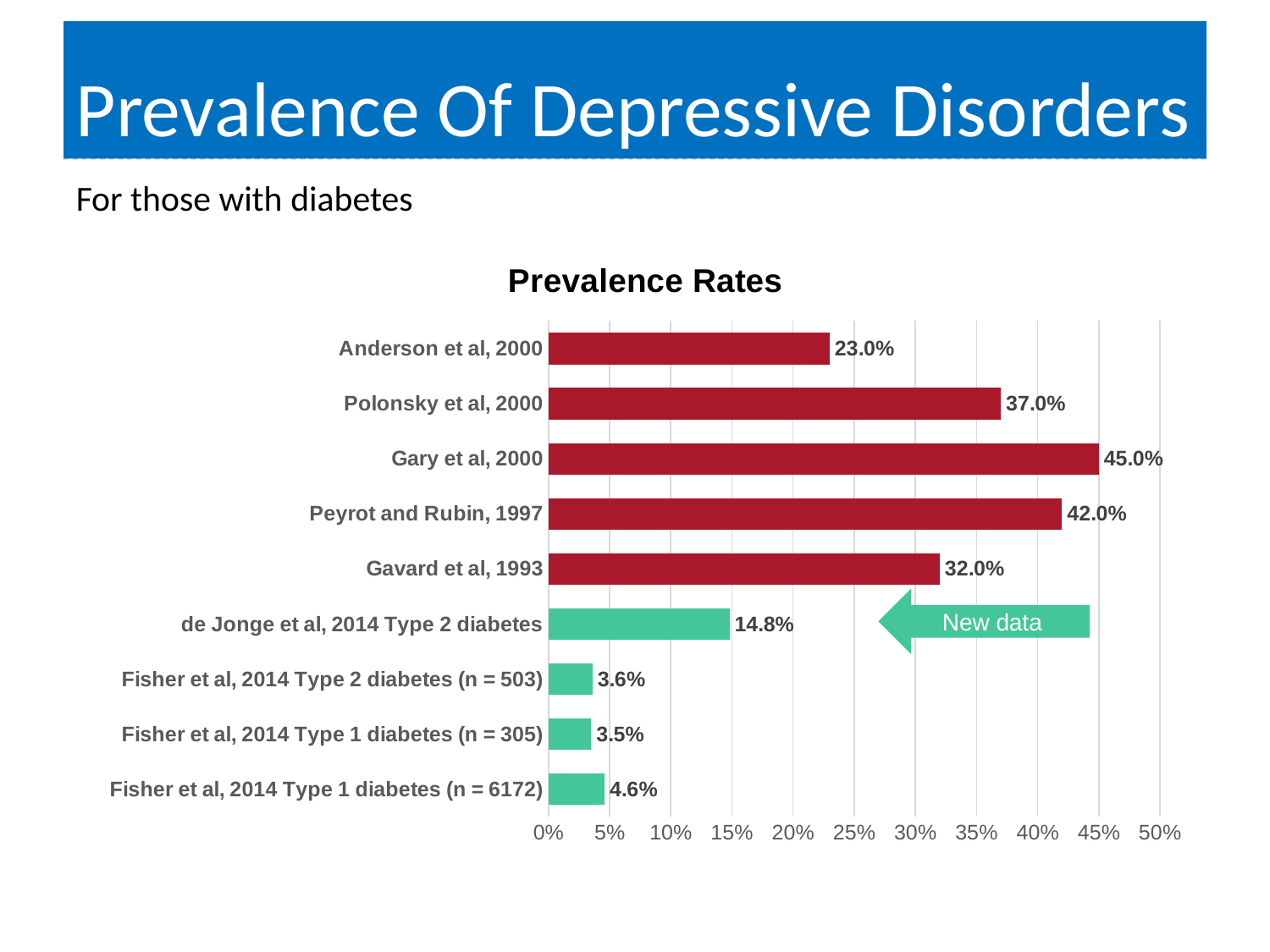
How many studies are shown in the chart? 9 What is the prevalence rate for Fisher et al, 2014 Type 1 diabetes (n = 6172)? 4.6% Which study has the lowest prevalence rate? Fisher et al, 2014 Type 1 diabetes (n = 305) What is the prevalence rate for Anderson et al, 2000? 23.0% What type of chart is shown on the slide? bar chart What does the arrow label pointing at the green bars say? New data Which has a higher prevalence rate, Polonsky et al, 2000 or Peyrot and Rubin, 1997? Peyrot and Rubin, 1997 What is the difference between the prevalence rates of Gary et al, 2000 and Gavard et al, 1993? 13.0% What is the prevalence rate for de Jonge et al, 2014 Type 2 diabetes? 14.8% Is the prevalence rate for Gavard et al, 1993 greater or less than 30%? greater Which study has the highest prevalence rate? Gary et al, 2000 What is the title of the chart? Prevalence Rates